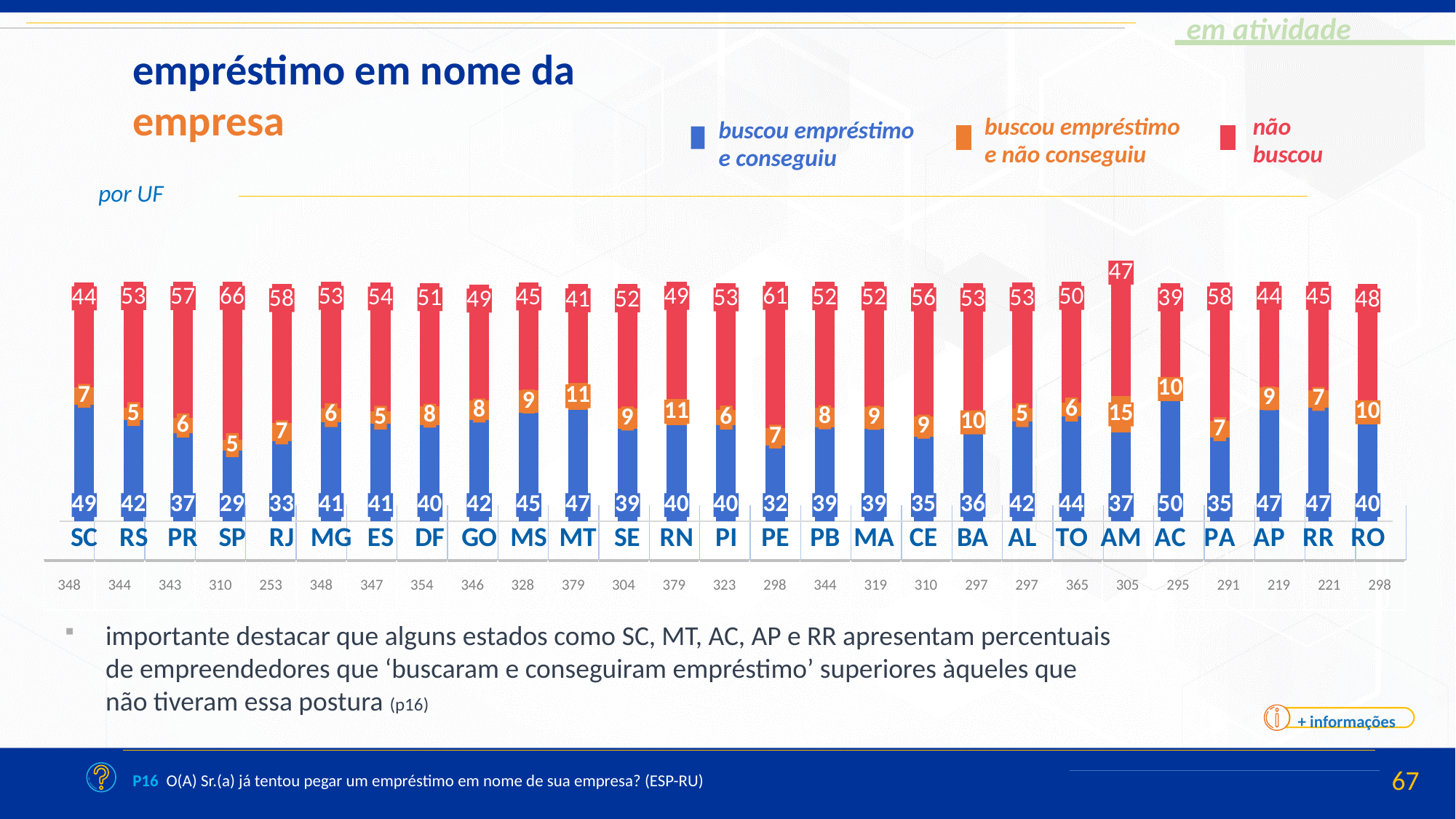
Which UF has the highest value for 'buscou empréstimo e conseguiu'? AC What is the value of 'buscou empréstimo e não conseguiu' for AM? 15 What kind of chart is shown on the slide? Stacked bar chart What colour represents 'não buscou' in the legend? Red Which has a larger 'buscou empréstimo e conseguiu' value, MT or PE? MT What is the value of 'buscou empréstimo e conseguiu' for SP? 29 Which UF has the lowest value for 'buscou empréstimo e conseguiu'? SP What is the total of the stacked bar for SC? 100 Which UF has the highest value for 'não buscou'? SP How many series does the legend list? 3 How many UFs are shown on the x axis of the chart? 27 What is the difference between the 'não buscou' values for SP and SC? 22